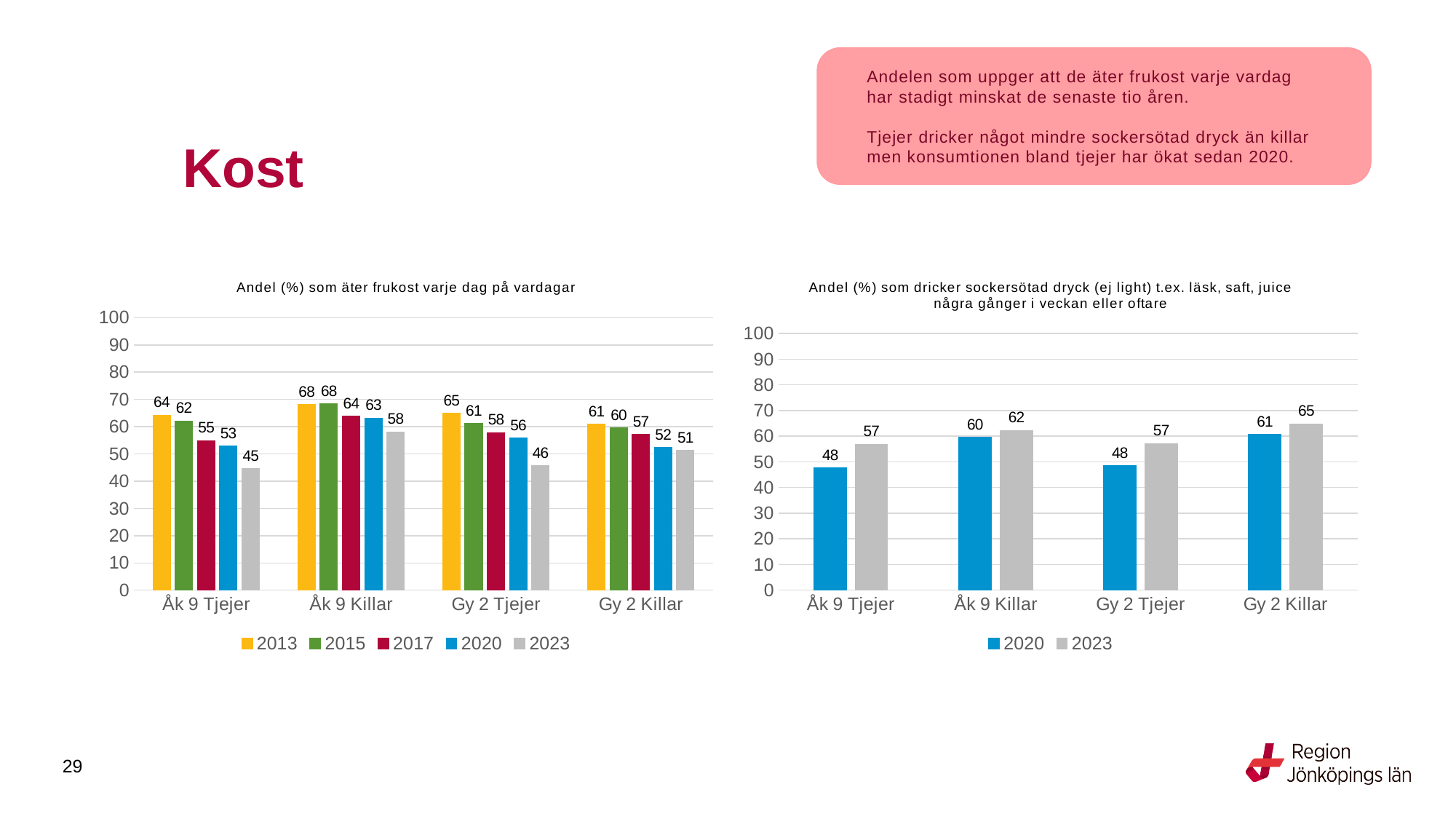
In the chart 'Andel (%) som äter frukost varje dag på vardagar', do the values for Gy 2 Tjejer rise or fall from 2013 to 2023? fall In the chart 'Andel (%) som dricker sockersötad dryck (ej light)...', how many categories are shown on the x axis? 4 In the chart 'Andel (%) som äter frukost varje dag på vardagar', which category has the highest value in 2023? Åk 9 Killar In the chart 'Andel (%) som äter frukost varje dag på vardagar', what is the value for Gy 2 Killar in 2013? 61 In the chart 'Andel (%) som äter frukost varje dag på vardagar', what is the value for Åk 9 Tjejer in 2023? 45 In the chart 'Andel (%) som dricker sockersötad dryck (ej light)...', what is the difference between the 2023 and 2020 values for Åk 9 Tjejer? 9 In the chart 'Andel (%) som dricker sockersötad dryck (ej light)...', what is the value for Gy 2 Killar in 2023? 65 What kind of chart is the chart on the right of the slide? bar chart In the chart 'Andel (%) som äter frukost varje dag på vardagar', which category has the lowest value in 2023? Åk 9 Tjejer In the chart 'Andel (%) som äter frukost varje dag på vardagar', what is the difference between the 2013 and 2023 values for Åk 9 Tjejer? 19 In the chart 'Andel (%) som äter frukost varje dag på vardagar', how many series does the legend list? 5 In the chart 'Andel (%) som dricker sockersötad dryck (ej light)...', which is larger: the 2020 value for Åk 9 Killar or the 2020 value for Gy 2 Tjejer? Åk 9 Killar